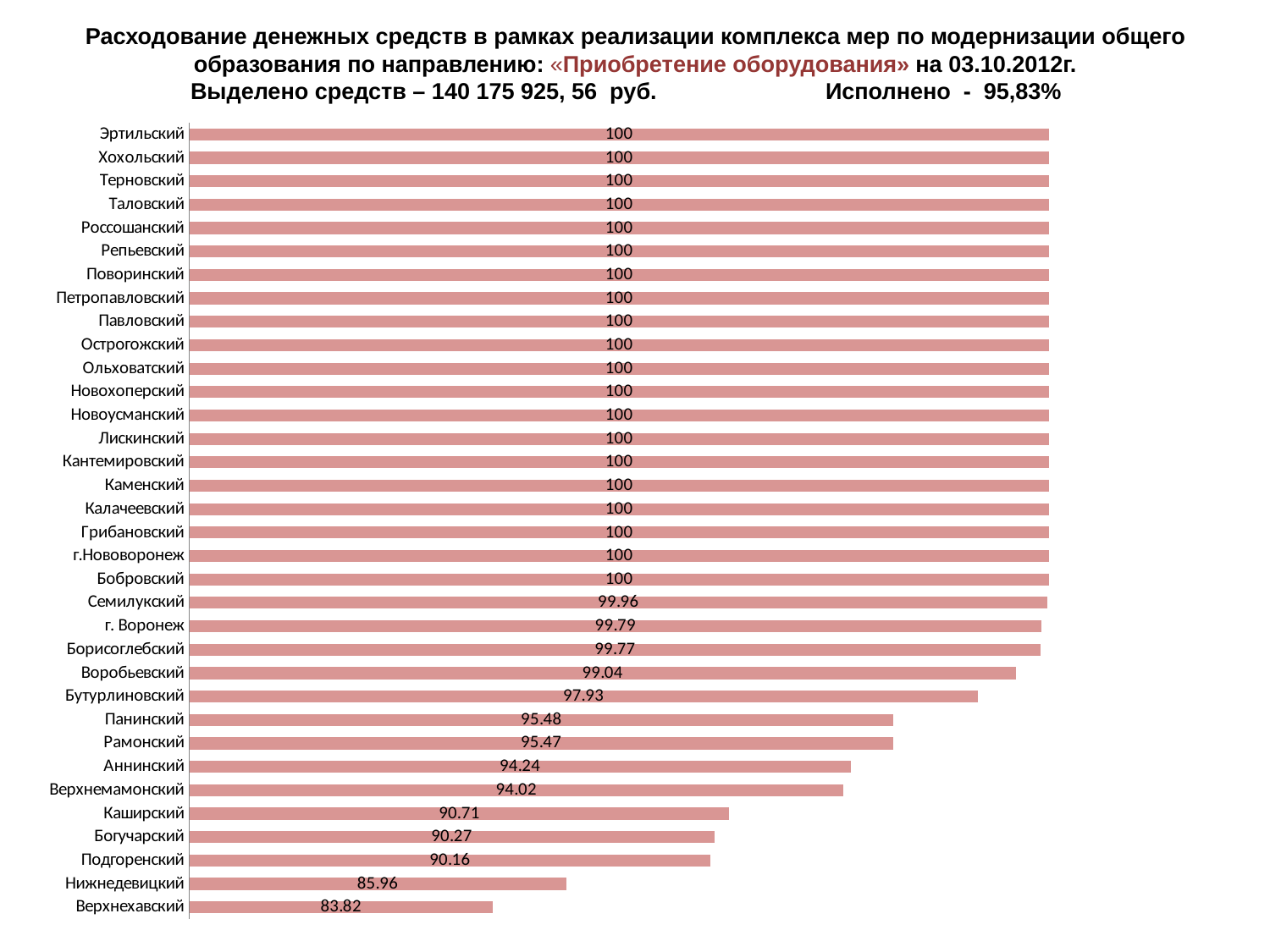
How many categories are shown in the chart? 34 How many categories have a value of 100? 20 What kind of chart is shown on the slide? Bar chart Which category has the lowest value? Верхнехавский What is the difference between the values for Нижнедевицкий and Верхнехавский? 2.14 Which is larger, the value for Аннинский or the value for Богучарский? Аннинский Which is larger, the value for Воробьевский or the value for Верхнемамонский? Воробьевский What is the value for Верхнехавский? 83.82 What is the value for г. Воронеж? 99.79 What is the difference between the values for Эртильский and Панинский? 4.52 What is the value for Каширский? 90.71 What is the value for Бутурлиновский? 97.93